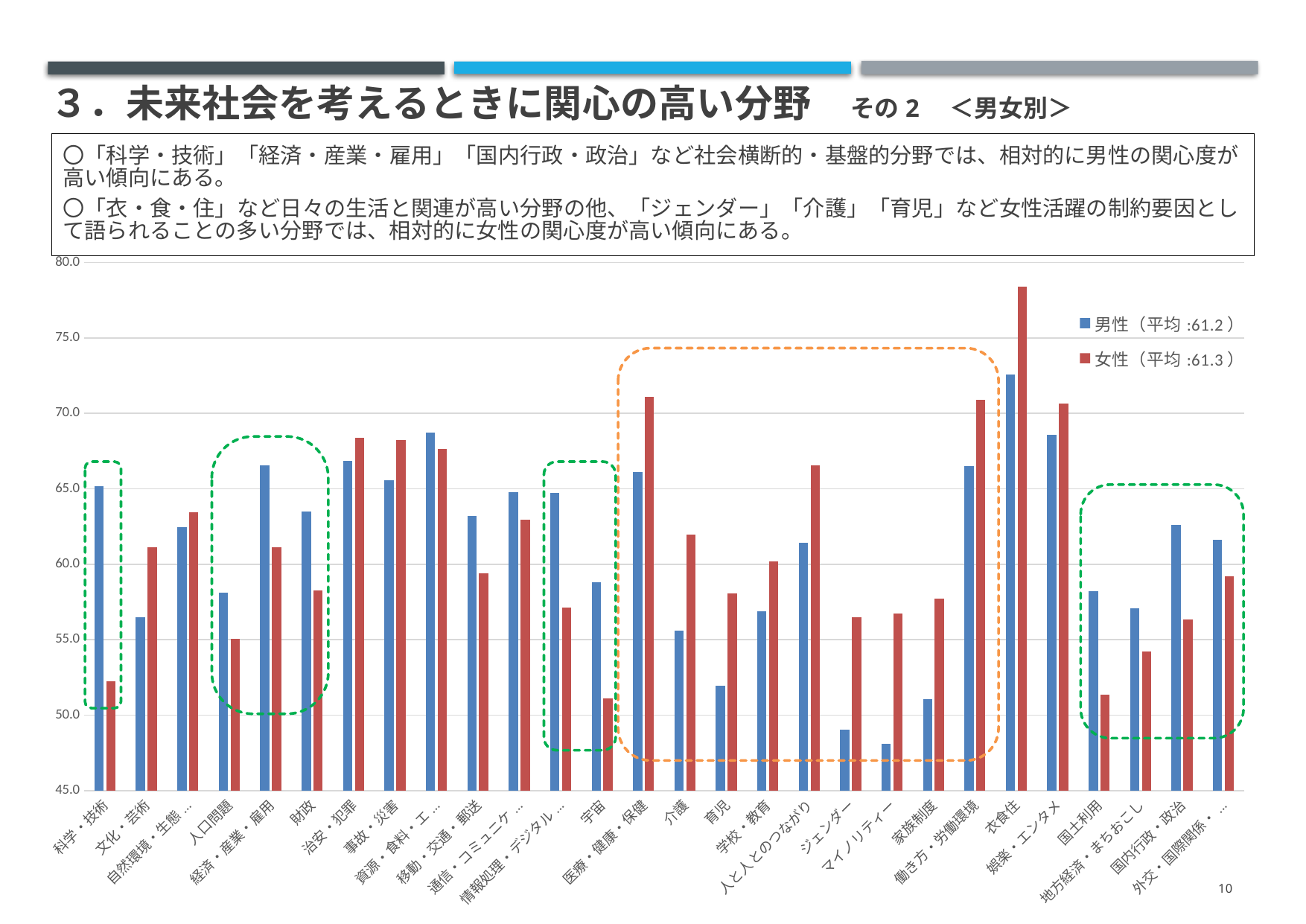
Is the 女性 value for 衣食住 greater or less than 75? greater Which category has the highest 男性 value? 衣食住 Which category has the highest 女性 value? 衣食住 What average value is shown in the legend for 女性? 61.3 What kind of chart is shown on the slide? bar chart How many categories are plotted along the x axis? 28 For 介護, which is larger, the 男性 value or the 女性 value? 女性 Is the 男性 value for マイノリティー greater or less than 50? less How many series does the legend list? 2 For 科学・技術, which is larger, the 男性 value or the 女性 value? 男性 What average value is shown in the legend for 男性? 61.2 Is the 女性 value for 科学・技術 greater or less than 55? less